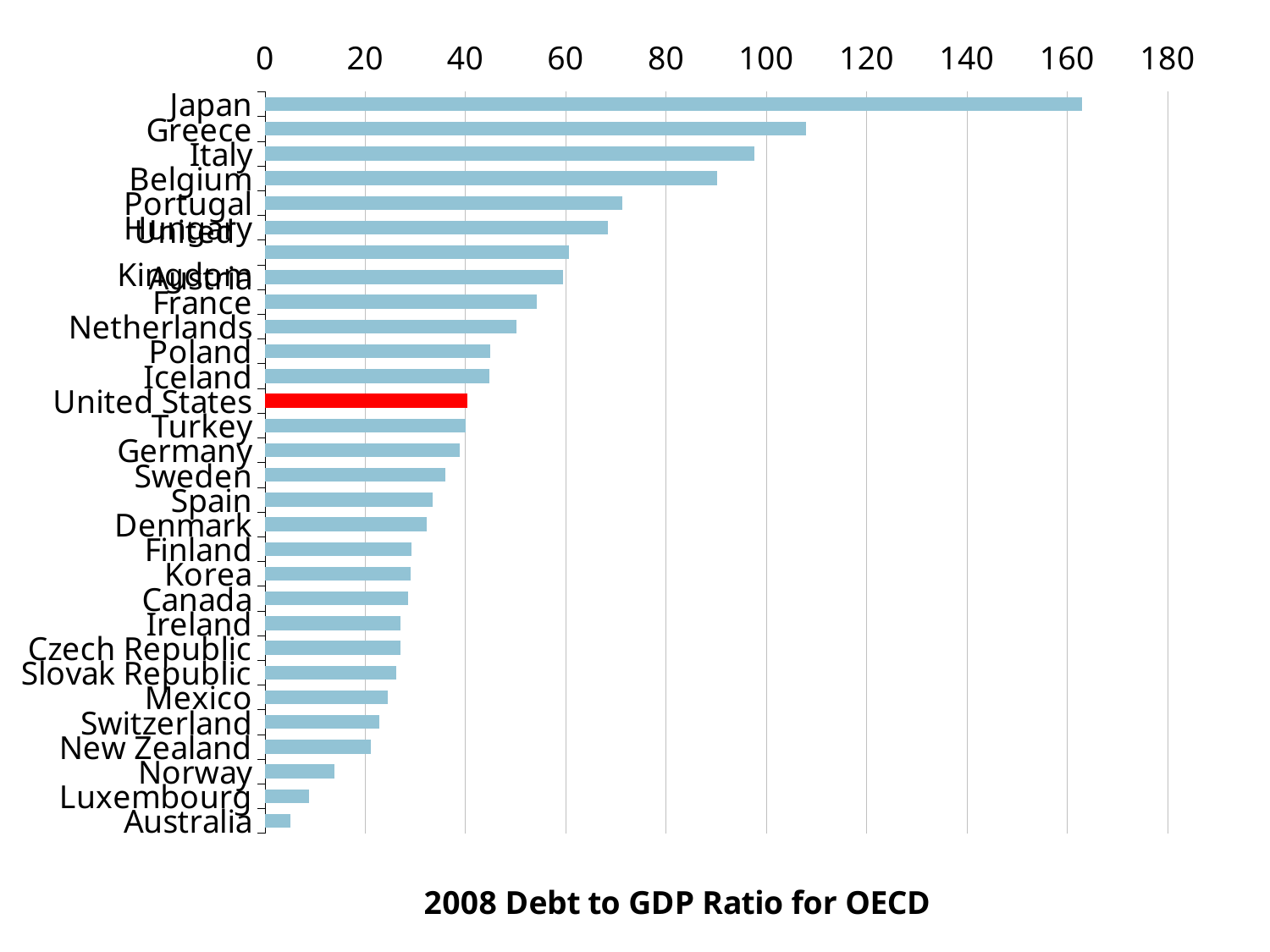
What kind of chart is shown on the slide? bar chart How many countries are shown in the chart? 30 What is the title of the chart? 2008 Debt to GDP Ratio for OECD Which country's bar is highlighted in red? United States Which has a higher debt to GDP ratio, Italy or Belgium? Italy Is the value for Belgium greater or less than 80? greater Is the value for Japan greater or less than 140? greater Which country has the lowest 2008 debt to GDP ratio? Australia Is the value for Greece greater or less than 100? greater Which country has the highest 2008 debt to GDP ratio? Japan